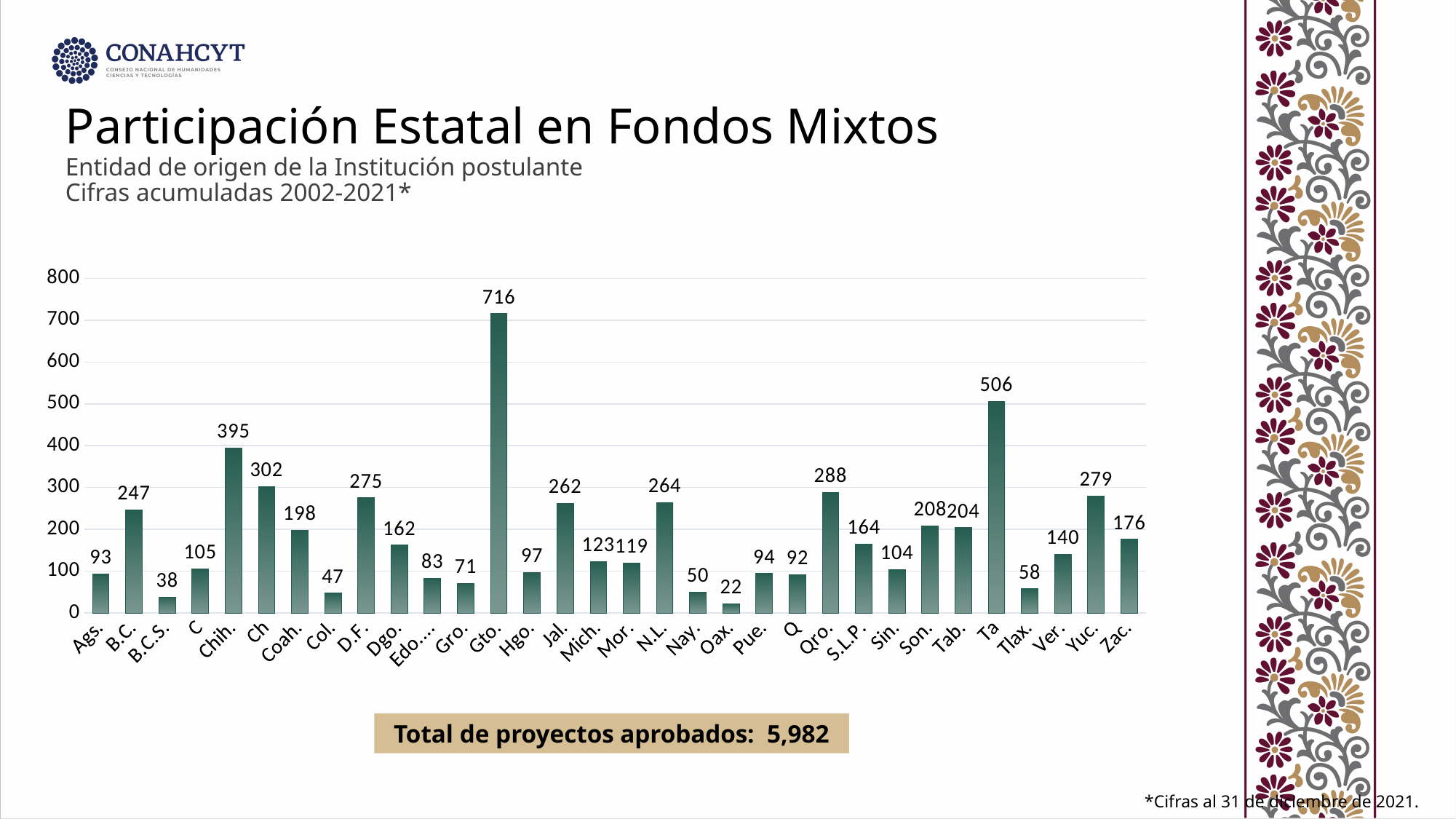
Is the value for Ch greater or less than 200? greater What is the title of the slide containing the chart? Participación Estatal en Fondos Mixtos How many categories are shown on the x axis? 32 What is the difference between the values for Gto. and Ta? 210 What is the value for Yuc.? 279 Which category has the lowest value? Oax. What kind of chart is shown on the slide? bar chart What is the value for Gto.? 716 What is the value for Oax.? 22 Which category has the highest value? Gto. Which is larger, the value for Qro. or the value for D.F.? Qro. What is the value for Chih.? 395